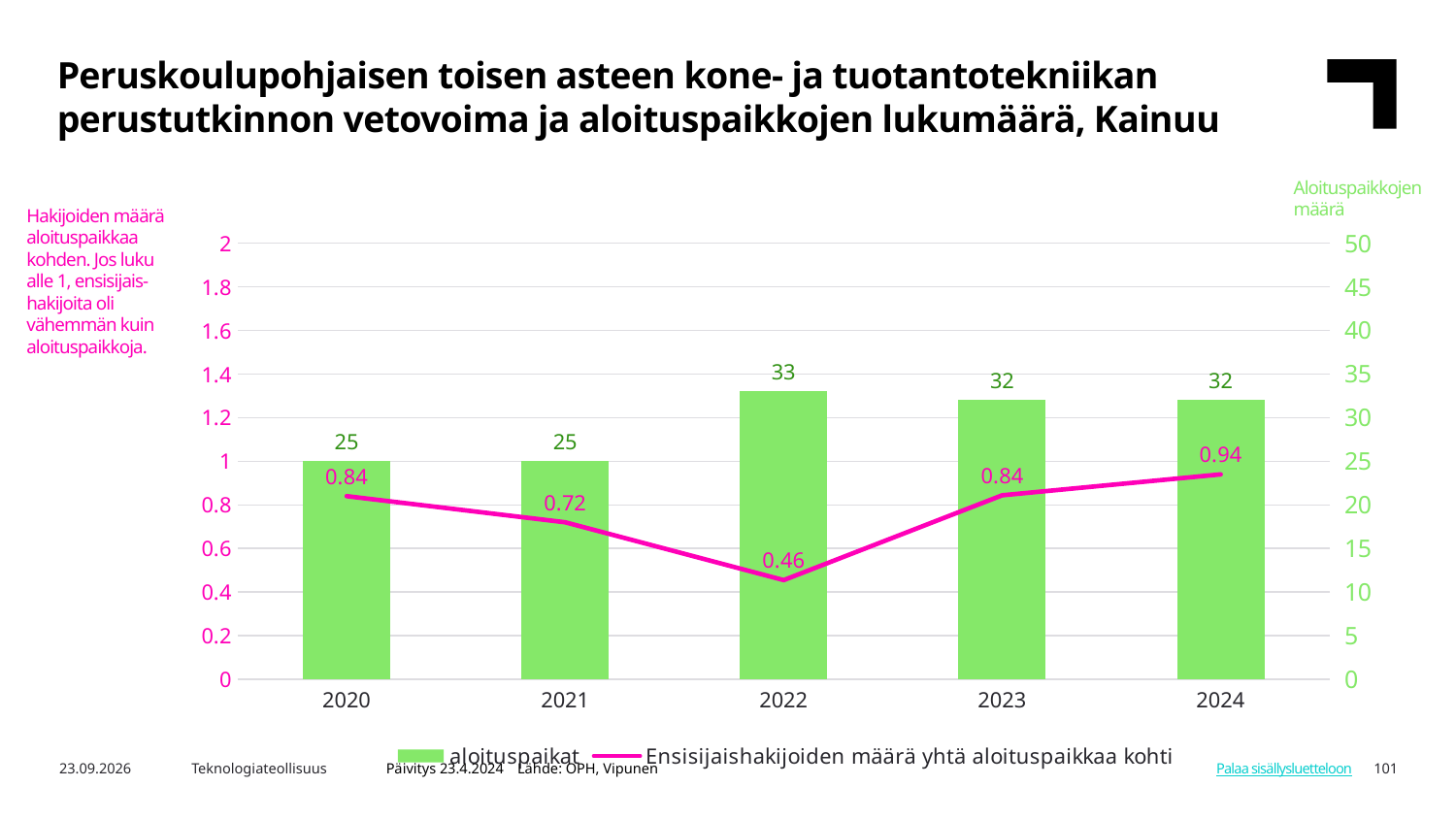
In which year is Ensisijaishakijoiden määrä yhtä aloituspaikkaa kohti lowest? 2022 How many years are shown on the x axis? 5 What is the difference in aloituspaikat between 2022 and 2020? 8 What is the value of Ensisijaishakijoiden määrä yhtä aloituspaikkaa kohti in 2021? 0.72 What is the value of aloituspaikat in 2022? 33 What is the value of aloituspaikat in 2020? 25 Which year has a higher value of Ensisijaishakijoiden määrä yhtä aloituspaikkaa kohti, 2021 or 2023? 2023 How many series does the legend list? 2 What is the difference in Ensisijaishakijoiden määrä yhtä aloituspaikkaa kohti between 2024 and 2022? 0.48 In which year is aloituspaikat highest? 2022 In which year is Ensisijaishakijoiden määrä yhtä aloituspaikkaa kohti highest? 2024 Does the line for Ensisijaishakijoiden määrä yhtä aloituspaikkaa kohti rise or fall from 2022 to 2024? rise